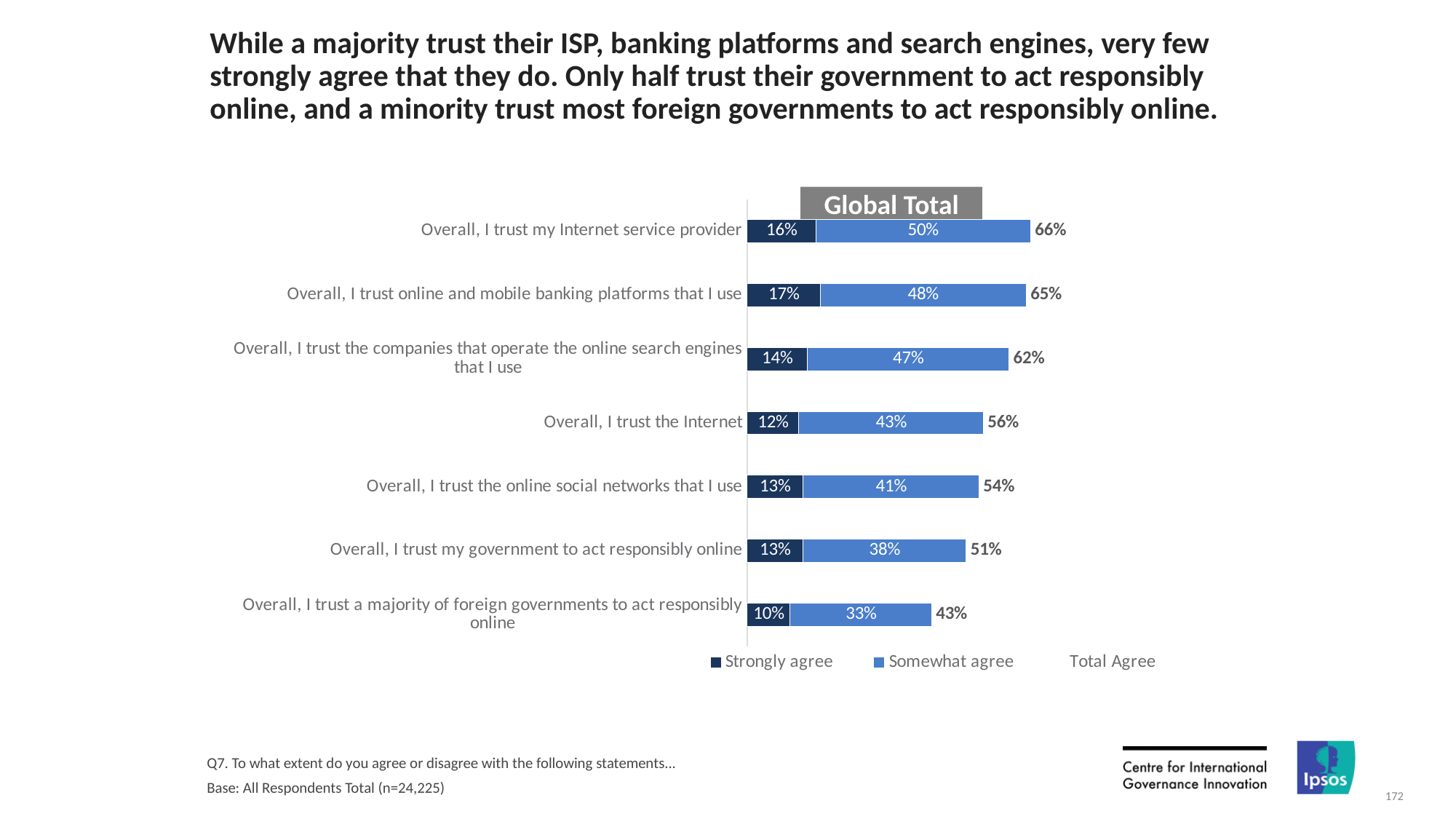
Which has a larger 'Somewhat agree' value: 'Overall, I trust the online social networks that I use' or 'Overall, I trust my government to act responsibly online'? Overall, I trust the online social networks that I use What is the header label shown above the chart? Global Total Which statement has the lowest 'Strongly agree' value? Overall, I trust a majority of foreign governments to act responsibly online How many entries does the legend list? 3 What kind of chart is shown on the slide? Stacked bar chart How many statements are shown in the chart? 7 What is the total of the stacked bar for 'Overall, I trust online and mobile banking platforms that I use'? 65% Which statement has the highest Total Agree value? Overall, I trust my Internet service provider What is the difference between the Total Agree values for 'Overall, I trust my Internet service provider' and 'Overall, I trust a majority of foreign governments to act responsibly online'? 23% What is the Total Agree value for 'Overall, I trust my government to act responsibly online'? 51% What is the 'Somewhat agree' value for 'Overall, I trust the Internet'? 43% What is the 'Strongly agree' value for 'Overall, I trust my Internet service provider'? 16%